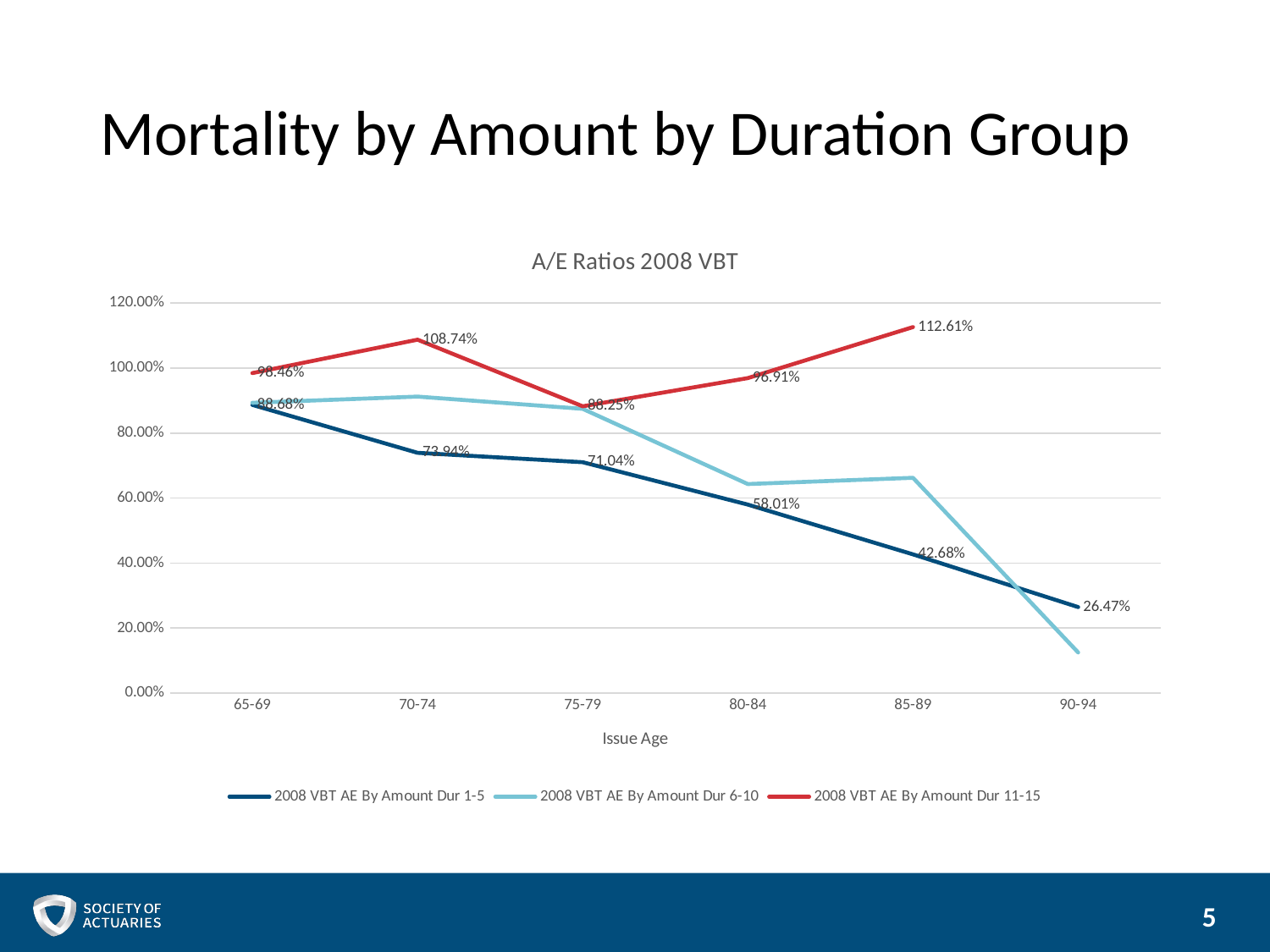
What is the value for 2008 VBT AE By Amount Dur 11-15 at issue age 70-74? 108.74% Does the 2008 VBT AE By Amount Dur 1-5 series rise or fall as issue age increases? Fall At which issue age is the 2008 VBT AE By Amount Dur 1-5 series lowest? 90-94 How many series does the legend list? 3 What is the value for 2008 VBT AE By Amount Dur 11-15 at issue age 85-89? 112.61% What is the value for 2008 VBT AE By Amount Dur 1-5 at issue age 80-84? 58.01% What is the value for 2008 VBT AE By Amount Dur 1-5 at issue age 90-94? 26.47% Is the value for 2008 VBT AE By Amount Dur 6-10 at issue age 90-94 greater or less than 20.00%? less At which issue age does the 2008 VBT AE By Amount Dur 11-15 series reach its highest value? 85-89 What kind of chart is shown on the slide? Line chart How many issue age groups are shown on the x axis? 6 What is the difference between the Dur 1-5 values at issue ages 80-84 and 85-89? 15.33%